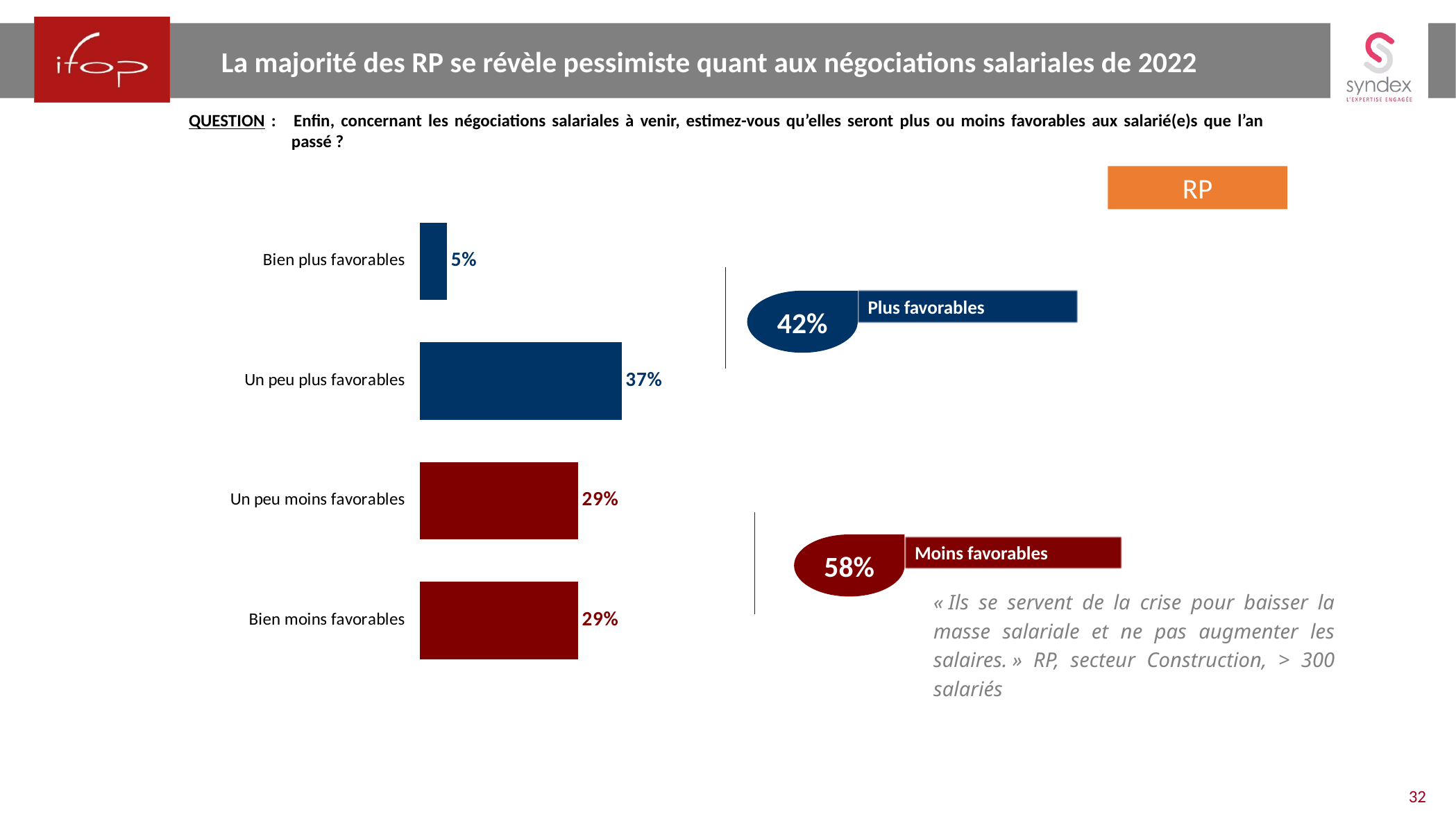
What is the combined share labelled "Plus favorables"? 42% What is the value for "Bien plus favorables"? 5% What is the difference between "Un peu plus favorables" and "Un peu moins favorables"? 8 points Which category has the highest value? Un peu plus favorables What is the combined share labelled "Moins favorables"? 58% How many categories are shown in the bar chart? 4 What kind of chart is shown on the slide? Bar chart What colour are the bars for the "moins favorables" categories? Dark red Which category has the lowest value? Bien plus favorables Which is larger, "Un peu plus favorables" or "Bien moins favorables"? Un peu plus favorables What is the value for "Un peu plus favorables"? 37% What is the value for "Bien moins favorables"? 29%